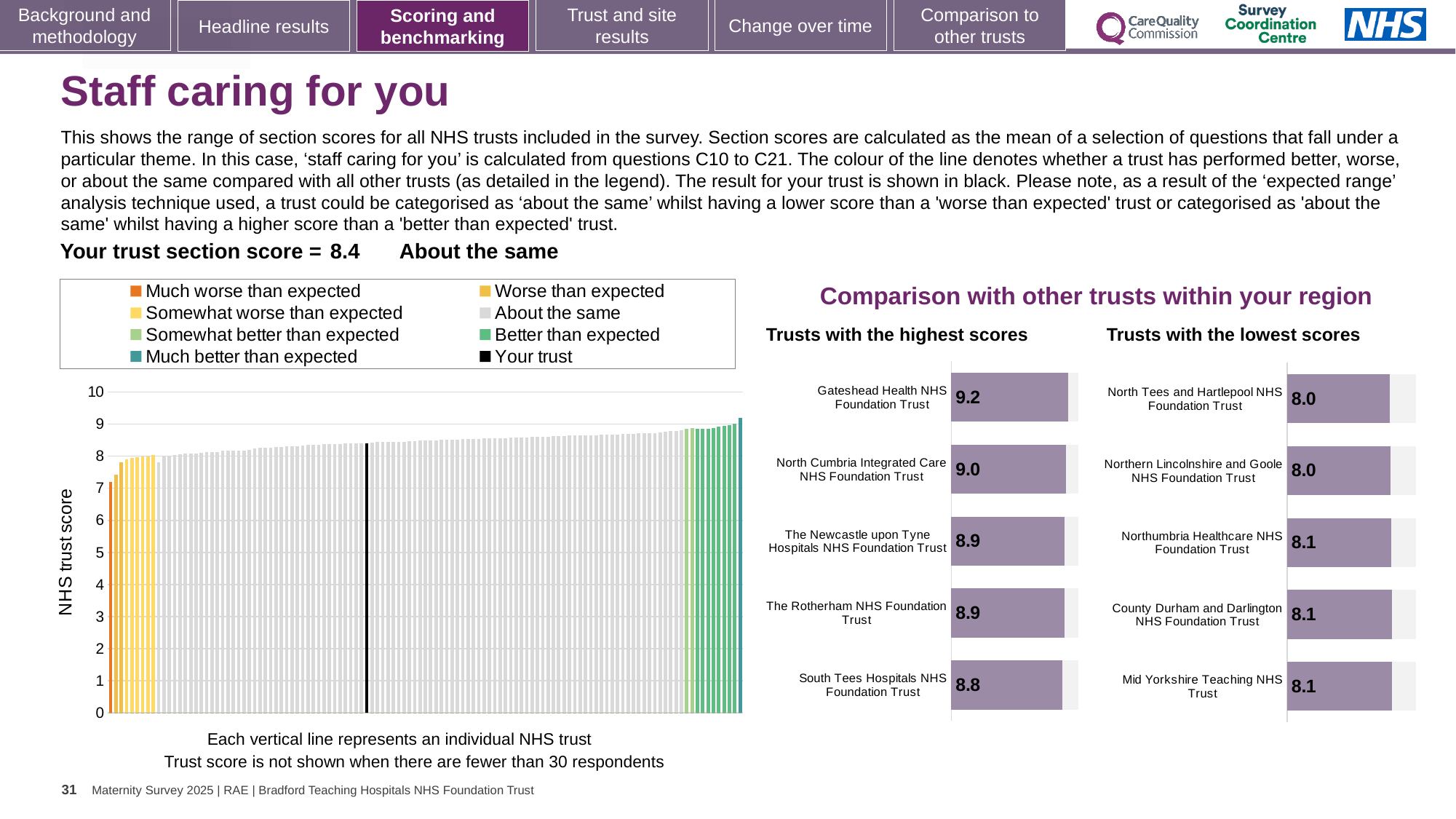
In the 'Trusts with the highest scores' chart, what is the difference between the scores of Gateshead Health NHS Foundation Trust and South Tees Hospitals NHS Foundation Trust? 0.4 According to the slide, what is your trust's section score for 'Staff caring for you'? 8.4 In the 'Trusts with the highest scores' chart, what is the score for South Tees Hospitals NHS Foundation Trust? 8.8 In the 'Trusts with the lowest scores' chart, what is the score for Mid Yorkshire Teaching NHS Trust? 8.1 In the 'Trusts with the highest scores' chart, what is the score for Gateshead Health NHS Foundation Trust? 9.2 In the 'Trusts with the highest scores' chart, which has the larger score: North Cumbria Integrated Care NHS Foundation Trust or The Newcastle upon Tyne Hospitals NHS Foundation Trust? North Cumbria Integrated Care NHS Foundation Trust In the main chart on the left, is the lowest trust score greater or less than 8? less How many entries does the legend of the main 'NHS trust score' chart on the left list? 8 What is the y-axis title of the main chart on the left? NHS trust score What kind of chart is the main chart on the left showing NHS trust scores? Bar chart In the 'Trusts with the highest scores' chart, which trust has the highest score? Gateshead Health NHS Foundation Trust How many trusts are shown in the 'Trusts with the lowest scores' chart? 5